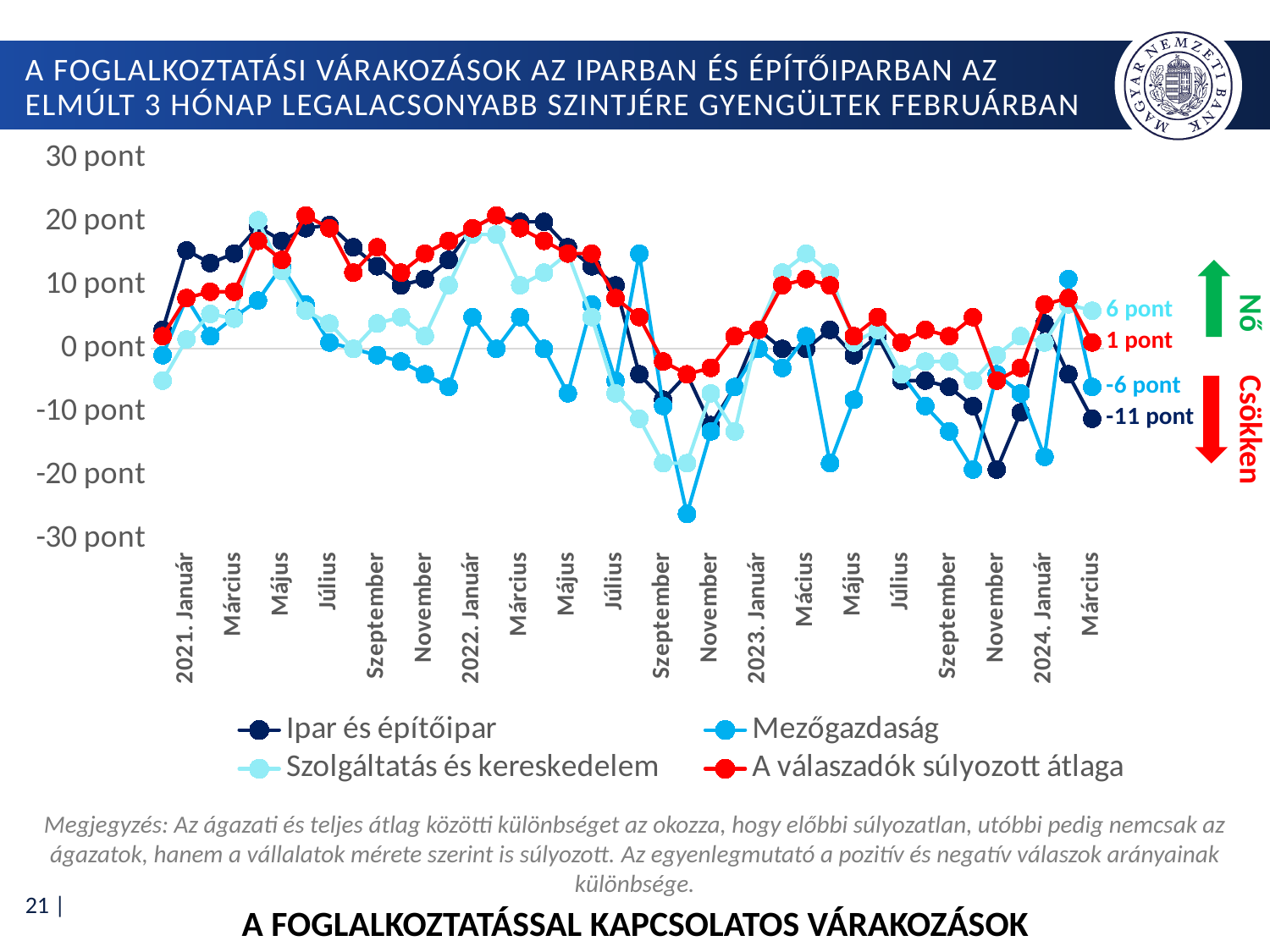
At the last data point (March 2024), which is larger: the value for A válaszadók súlyozott átlaga or the value for Mezőgazdaság? A válaszadók súlyozott átlaga Which series has the highest labelled value at the last data point (March 2024)? Szolgáltatás és kereskedelem How many series does the legend list? 4 Is the value for A válaszadók súlyozott átlaga in March 2022 greater or less than 10 pont? greater What is the value labelled for Szolgáltatás és kereskedelem at the end of the series (March 2024)? 6 pont What is the value labelled for Ipar és építőipar at the end of the series (March 2024)? -11 pont What is the value labelled for Mezőgazdaság at the end of the series (March 2024)? -6 pont What is the value labelled for A válaszadók súlyozott átlaga at the end of the series (March 2024)? 1 pont Is the value for Mezőgazdaság in September 2022 greater or less than -20 pont? greater Which series has the lowest labelled value at the last data point (March 2024)? Ipar és építőipar What is the difference between the labelled March 2024 values of Szolgáltatás és kereskedelem and Ipar és építőipar? 17 pont What kind of chart is shown on the slide? line chart